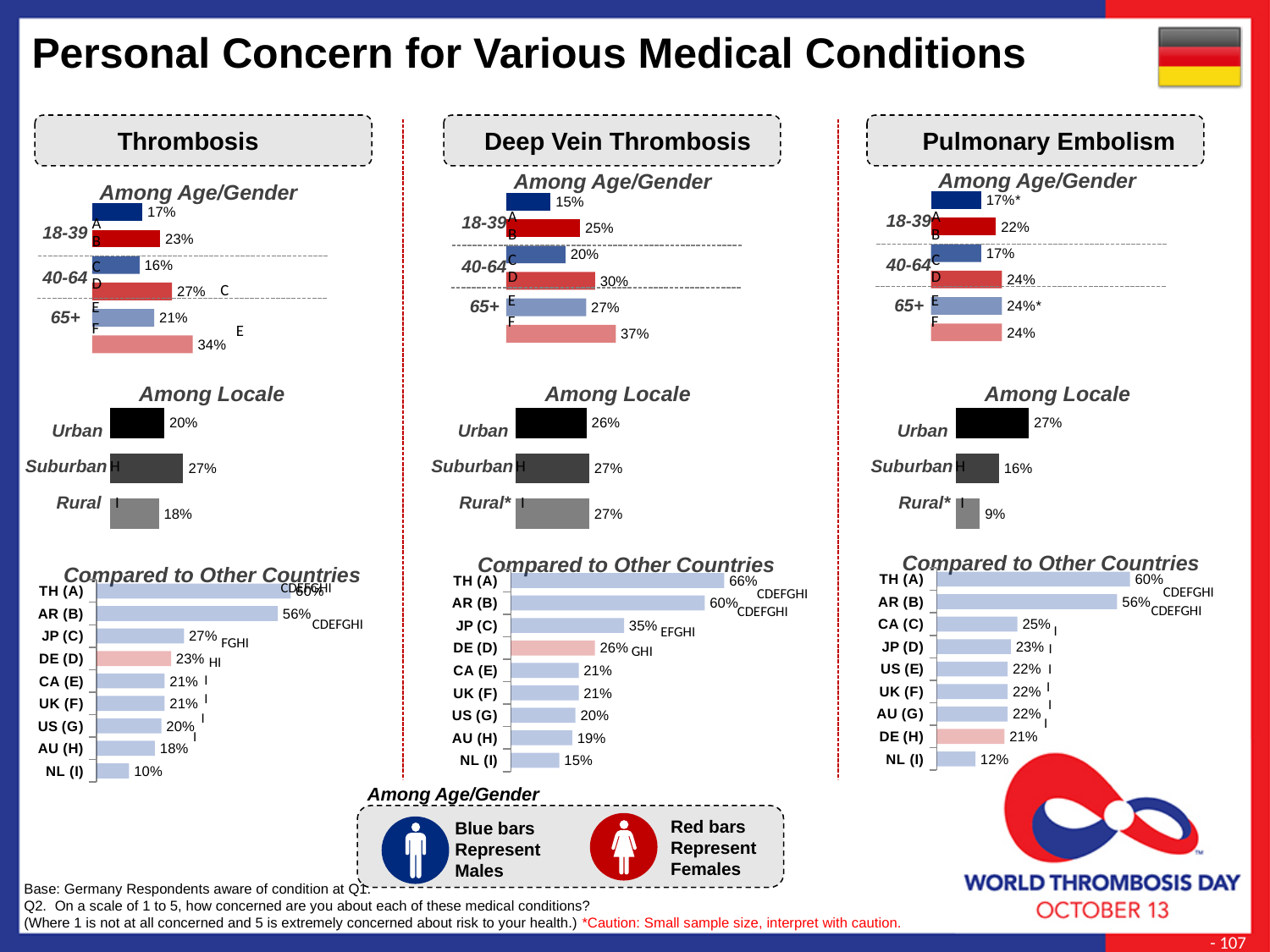
In the Deep Vein Thrombosis 'Compared to Other Countries' chart, what is the value for DE (D)? 26% In the Deep Vein Thrombosis 'Among Locale' chart, what is the value for Urban? 26% In the Thrombosis 'Compared to Other Countries' chart, which country has the highest value? TH (A) What type of chart is used in the Thrombosis 'Compared to Other Countries' section? Bar chart In the Deep Vein Thrombosis 'Among Age/Gender' chart, what is the value for bar F (females 65+)? 37% How many countries are listed in the Pulmonary Embolism 'Compared to Other Countries' chart? 9 In the Thrombosis 'Among Locale' chart, what is the value for Suburban? 27% According to the legend at the bottom of the slide, what do the red bars in the 'Among Age/Gender' charts represent? Females In the Pulmonary Embolism 'Compared to Other Countries' chart, what is the difference between TH (A) and NL (I)? 48% In the Pulmonary Embolism 'Among Locale' chart, what is the value for Rural*? 9% In the Deep Vein Thrombosis 'Compared to Other Countries' chart, which country has the lowest value? NL (I)